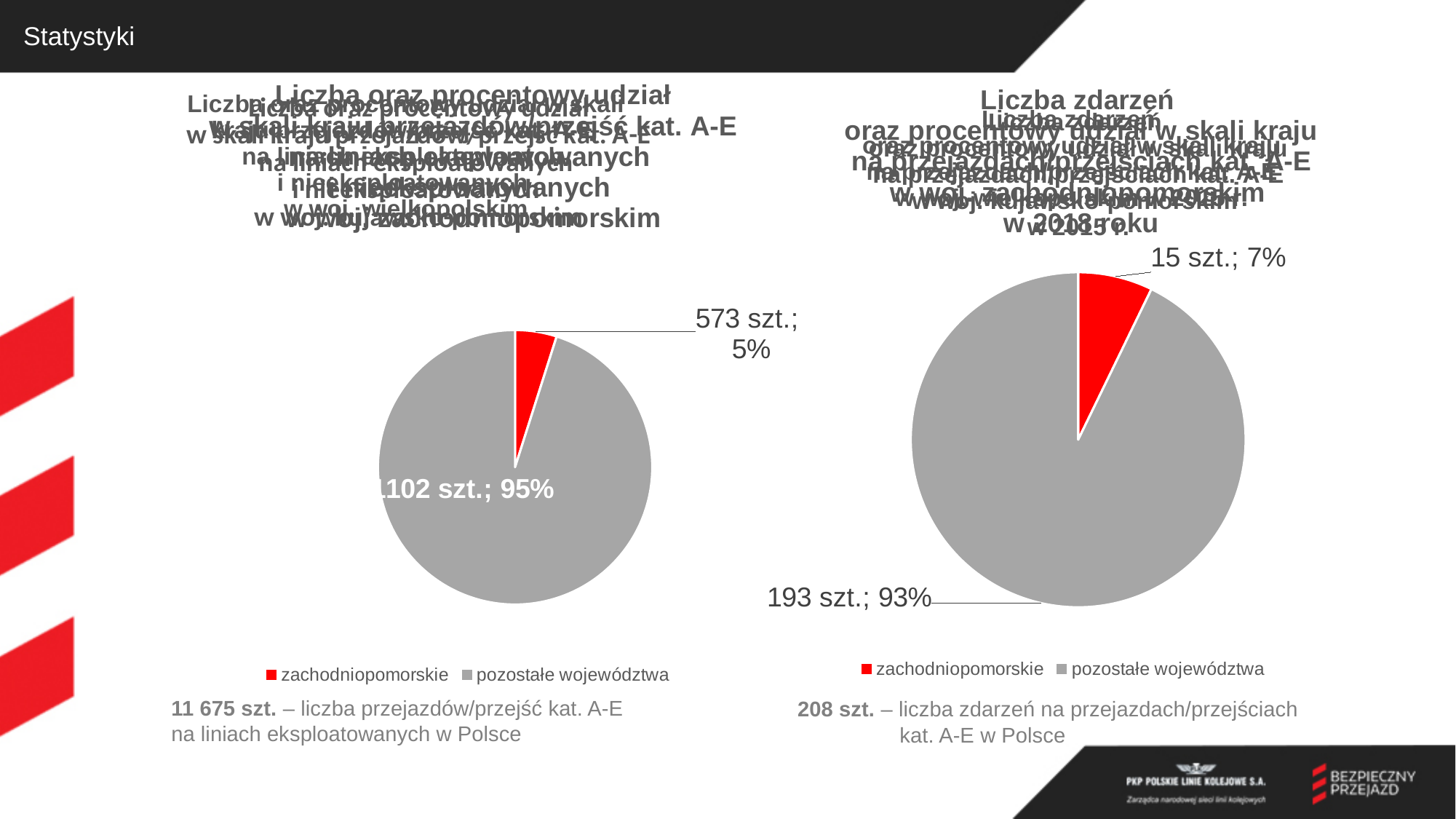
What kind of chart is the right chart on the slide? pie chart In the right pie chart, what is the difference in count between pozostałe województwa and zachodniopomorskie? 178 szt. What kind of chart is the left chart on the slide? pie chart In the right pie chart, what value is shown for pozostałe województwa? 193 szt.; 93% In the left pie chart, what value is shown for zachodniopomorskie? 573 szt.; 5% In the left pie chart, which colour represents zachodniopomorskie? red In the right pie chart, what value is shown for zachodniopomorskie? 15 szt.; 7% In the left pie chart, what percentage share does pozostałe województwa have? 95% In the left pie chart, which slice is the smallest? zachodniopomorskie In the right pie chart, what percentage share does zachodniopomorskie have? 7% How many entries does the legend of the right pie chart list? 2 In the right pie chart, which slice is the largest? pozostałe województwa